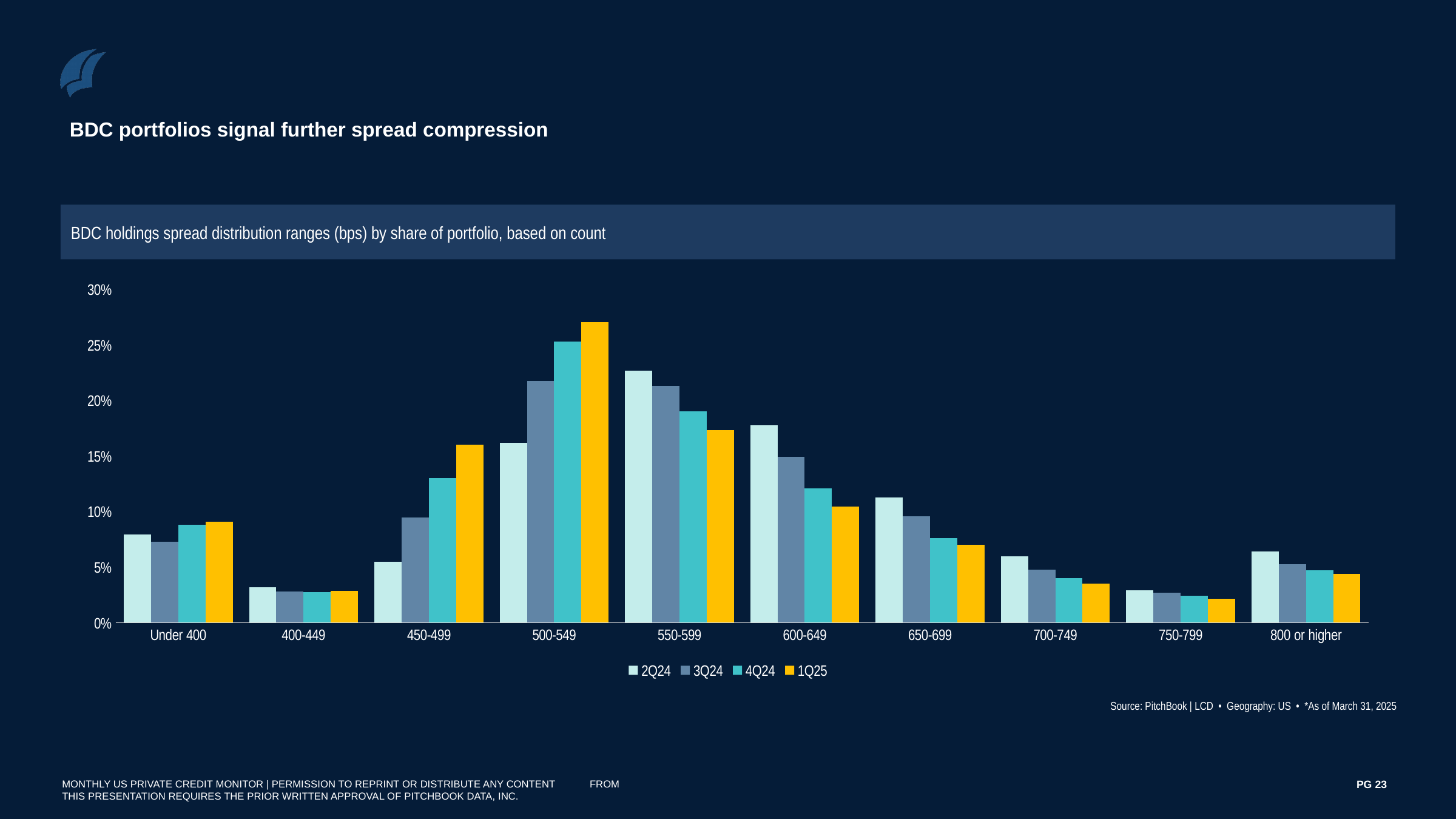
For the 550-599 range, which is larger: the 2Q24 value or the 1Q25 value? 2Q24 Which spread range has the highest 2Q24 bar? 550-599 Is the 1Q25 value for 500-549 greater or less than 25%? greater Is the 4Q24 value for 450-499 greater or less than 10%? greater Which spread range has the highest 1Q25 bar? 500-549 For the 600-649 range, do the values rise or fall from 2Q24 to 1Q25? fall For the 450-499 range, which is larger: the 2Q24 value or the 1Q25 value? 1Q25 What kind of chart is shown on the slide? Bar chart How many spread range categories are shown on the x axis? 10 How many series does the legend list? 4 Which colour represents the 1Q25 series in the legend? Yellow Is the 2Q24 value for 500-549 greater or less than 20%? less